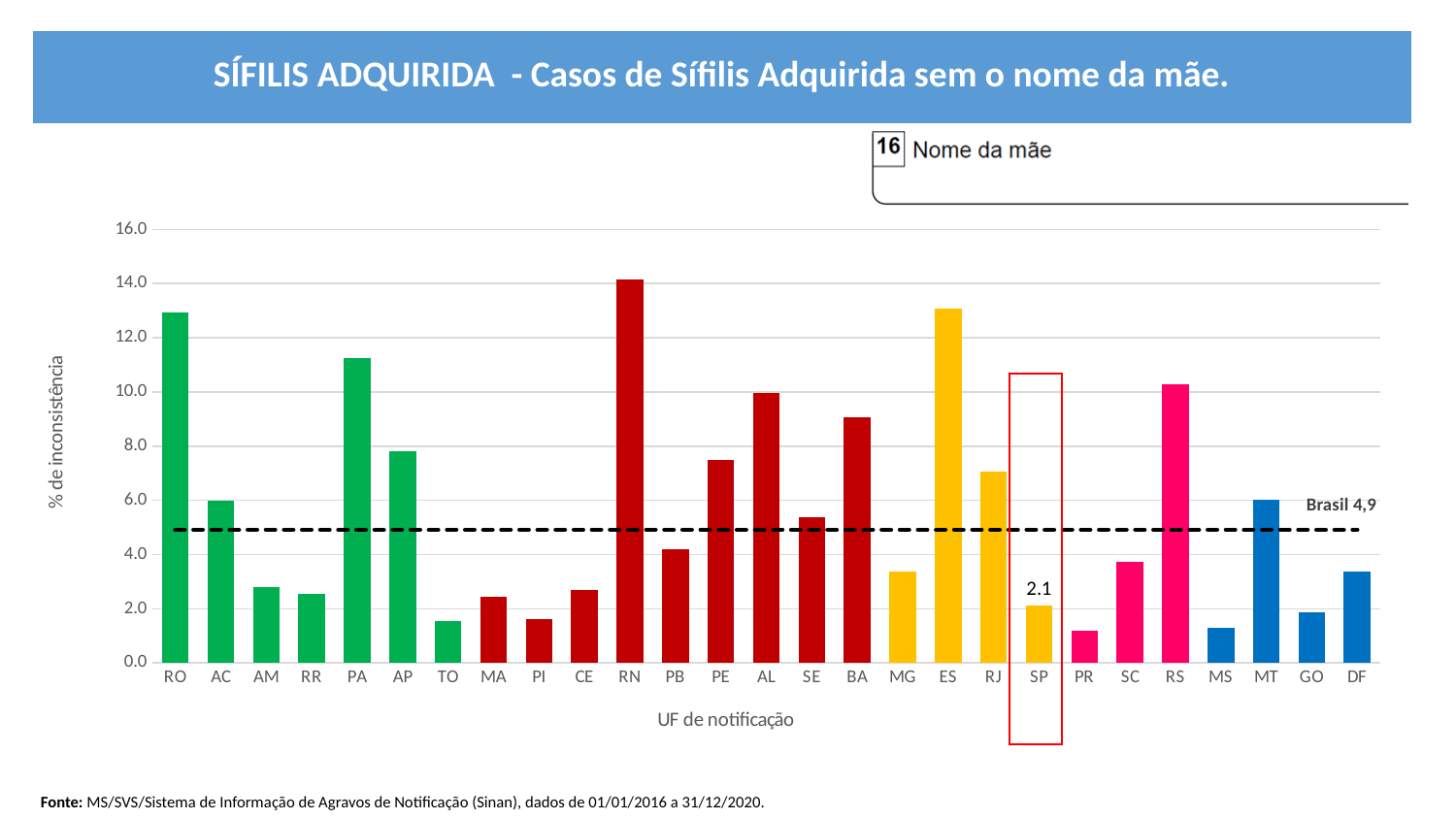
Is the value for AL greater or less than 8.0? greater What kind of chart is shown on the slide? bar chart Which has a larger value, PA or AP? PA Which UF has the highest value? RN What is the value for SP? 2.1 Is the value for DF greater or less than 4.0? less Is the value for RO greater or less than 12.0? greater How many UFs are shown on the x axis? 27 What is the title of the x axis? UF de notificação What value does the dashed reference line for Brasil indicate? 4,9 Which has a larger value, BA or PE? BA